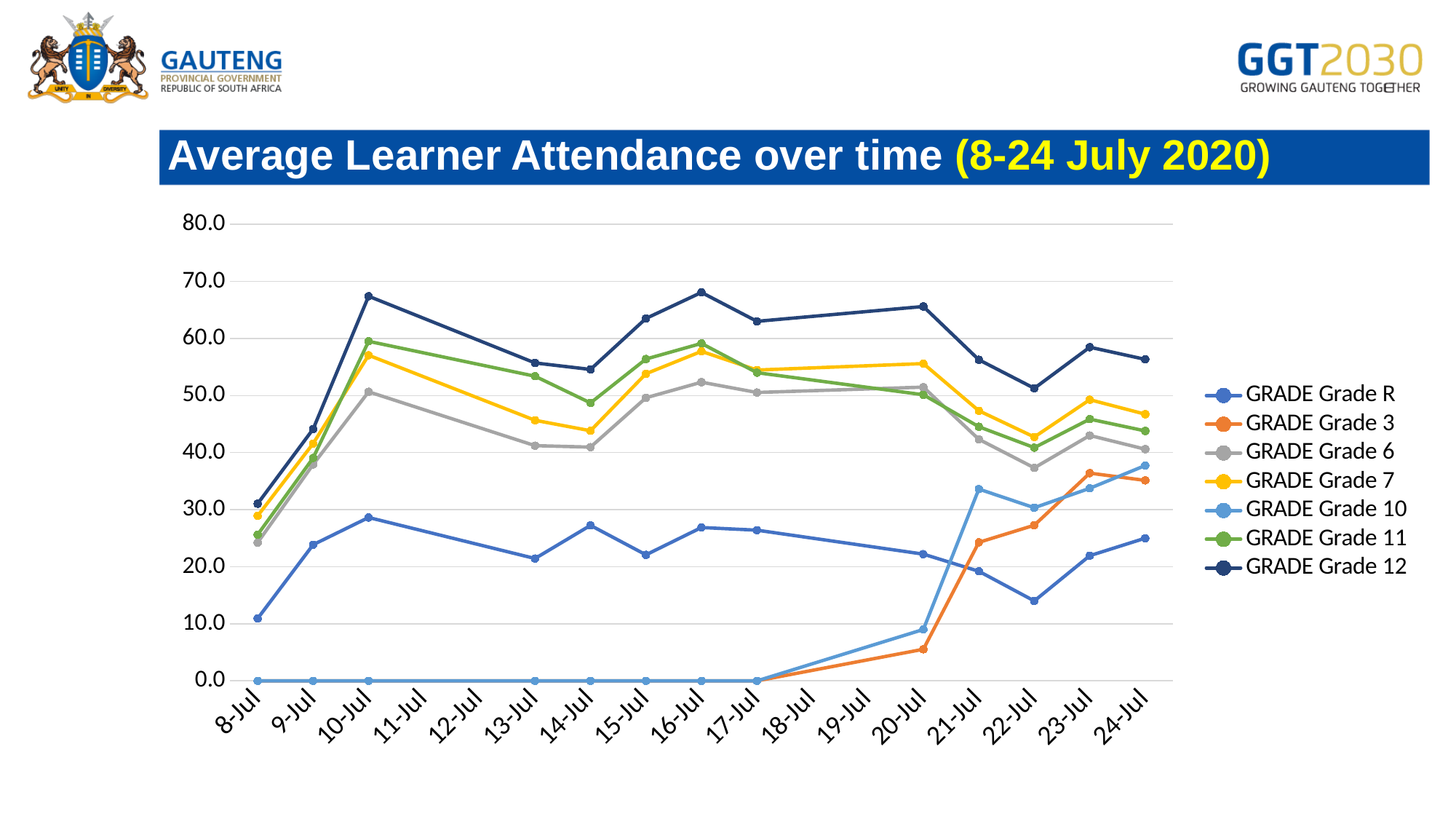
Which series has the lowest value on 24-Jul? GRADE Grade R Does the value for GRADE Grade 3 rise or fall from 17-Jul to 23-Jul? rise Is the value for GRADE Grade 12 on 10-Jul greater or less than 60? greater What is the value for GRADE Grade 10 on 8-Jul? 0.0 What kind of chart is shown on the slide? line chart What is the value for GRADE Grade 3 on 17-Jul? 0.0 How many date labels are shown along the x axis? 17 Is the value for GRADE Grade 7 on 20-Jul greater or less than 50? greater Is the value for GRADE Grade 6 on 22-Jul greater or less than 40? less How many series does the legend list? 7 Which series has the highest value on 16-Jul? GRADE Grade 12